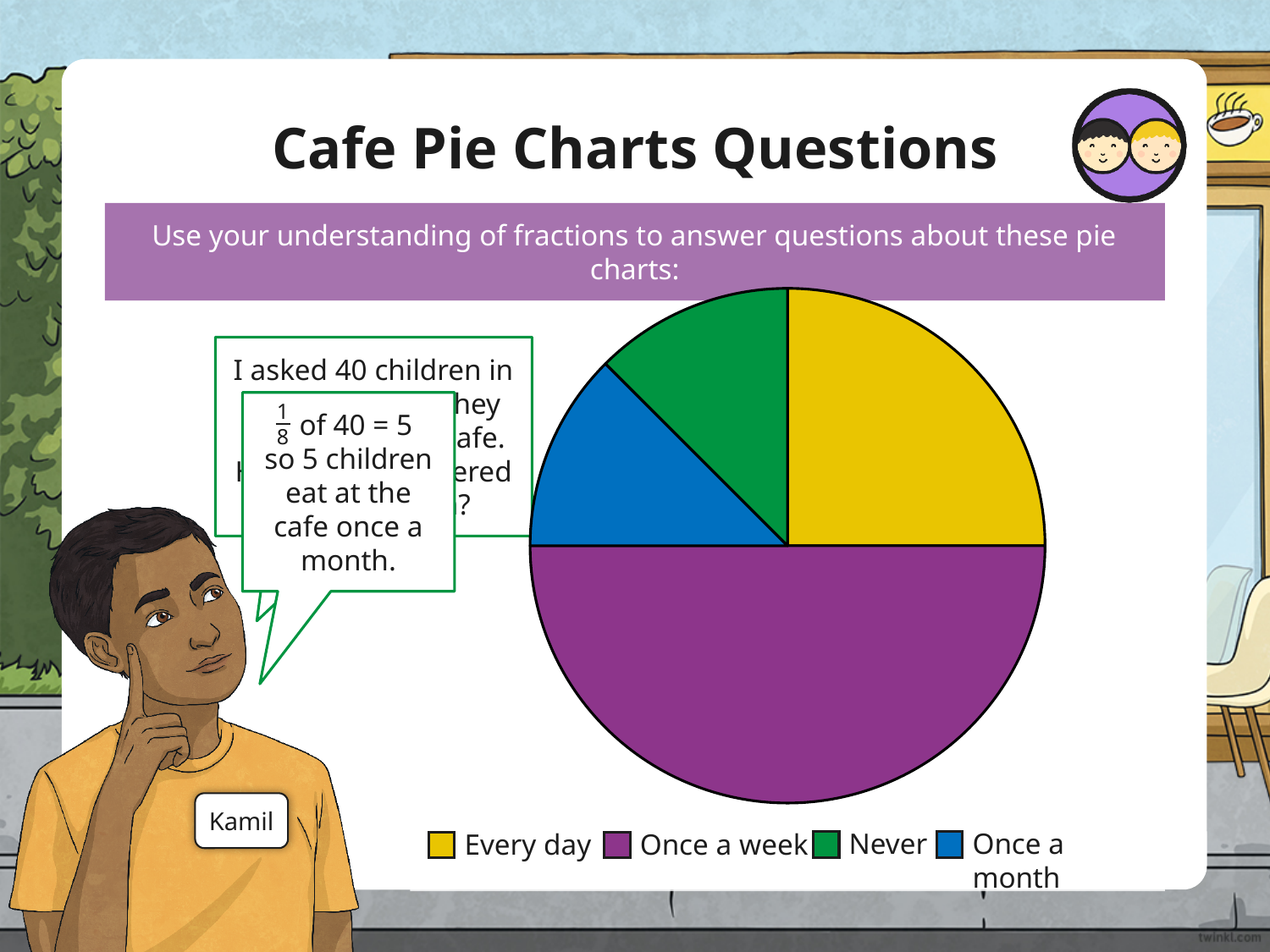
What fraction of the pie chart does the Once a month slice represent, according to the speech bubble? 1/8 According to the speech bubble, how many children eat at the cafe once a month? 5 Which slice is larger, Every day or Never? Every day How many children were asked in total, according to the speech bubble? 40 What is the title of the slide? Cafe Pie Charts Questions Which category takes up the largest slice of the pie chart? Once a week What kind of chart is shown on the slide? pie chart How many entries does the legend of the pie chart list? 4 Which colour represents Never in the pie chart? green Which slice is larger, Once a week or Once a month? Once a week Which slice is larger, Every day or Once a week? Once a week How many slices does the pie chart have? 4